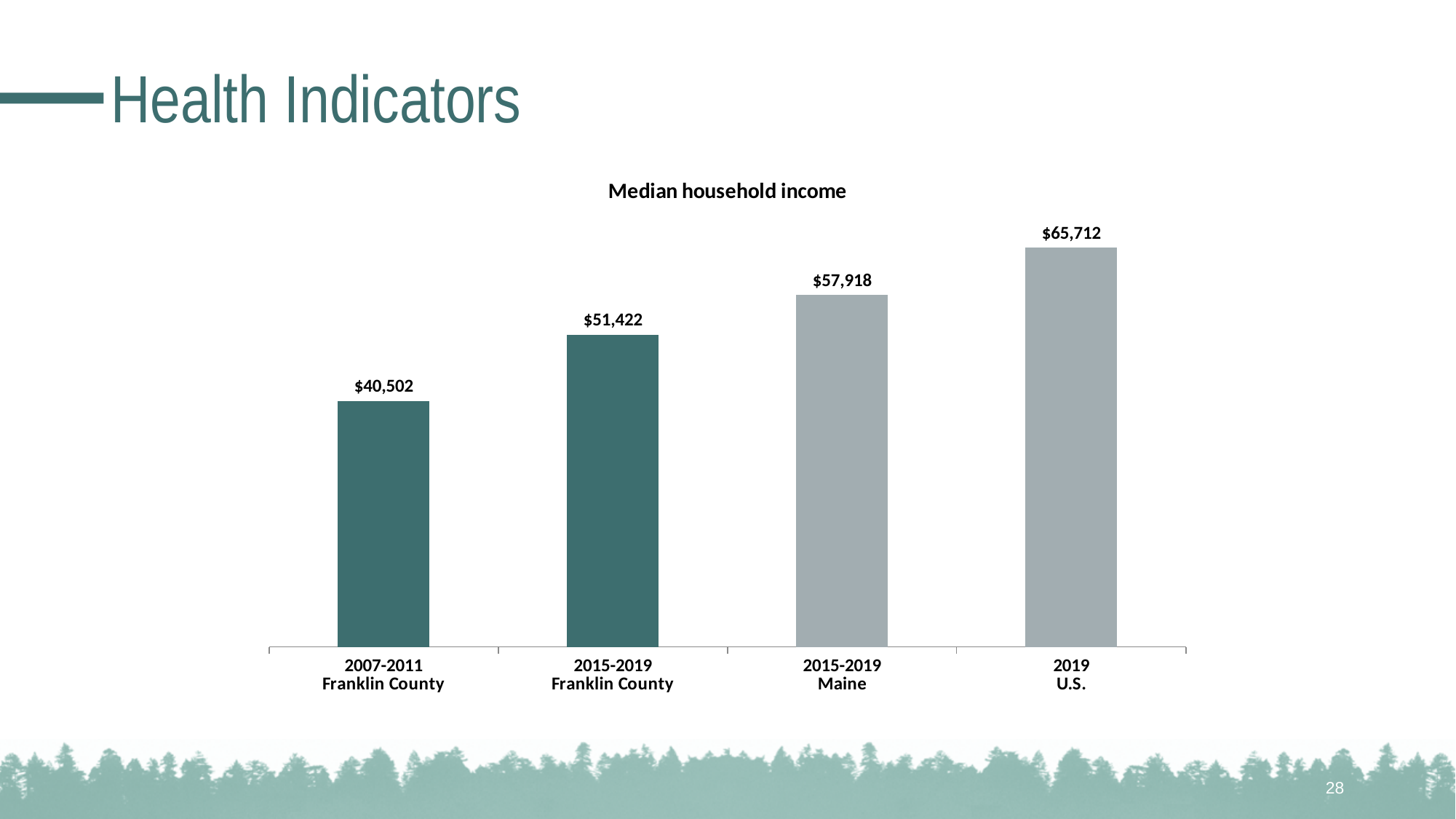
Which category has the lowest median household income? 2007-2011 Franklin County What is the difference between the 2019 U.S. median household income and the 2015-2019 Franklin County median household income? $14,290 Which category has the highest median household income? 2019 U.S. What is the median household income for 2015-2019 Maine? $57,918 What is the title of the chart? Median household income What is the median household income for 2007-2011 Franklin County? $40,502 Which is larger, the median household income for 2015-2019 Maine or for 2015-2019 Franklin County? 2015-2019 Maine How many categories are shown in the chart? 4 What kind of chart is shown on the slide? Bar chart What is the median household income for 2015-2019 Franklin County? $51,422 How much did Franklin County's median household income increase from 2007-2011 to 2015-2019? $10,920 What is the median household income for 2019 U.S.? $65,712